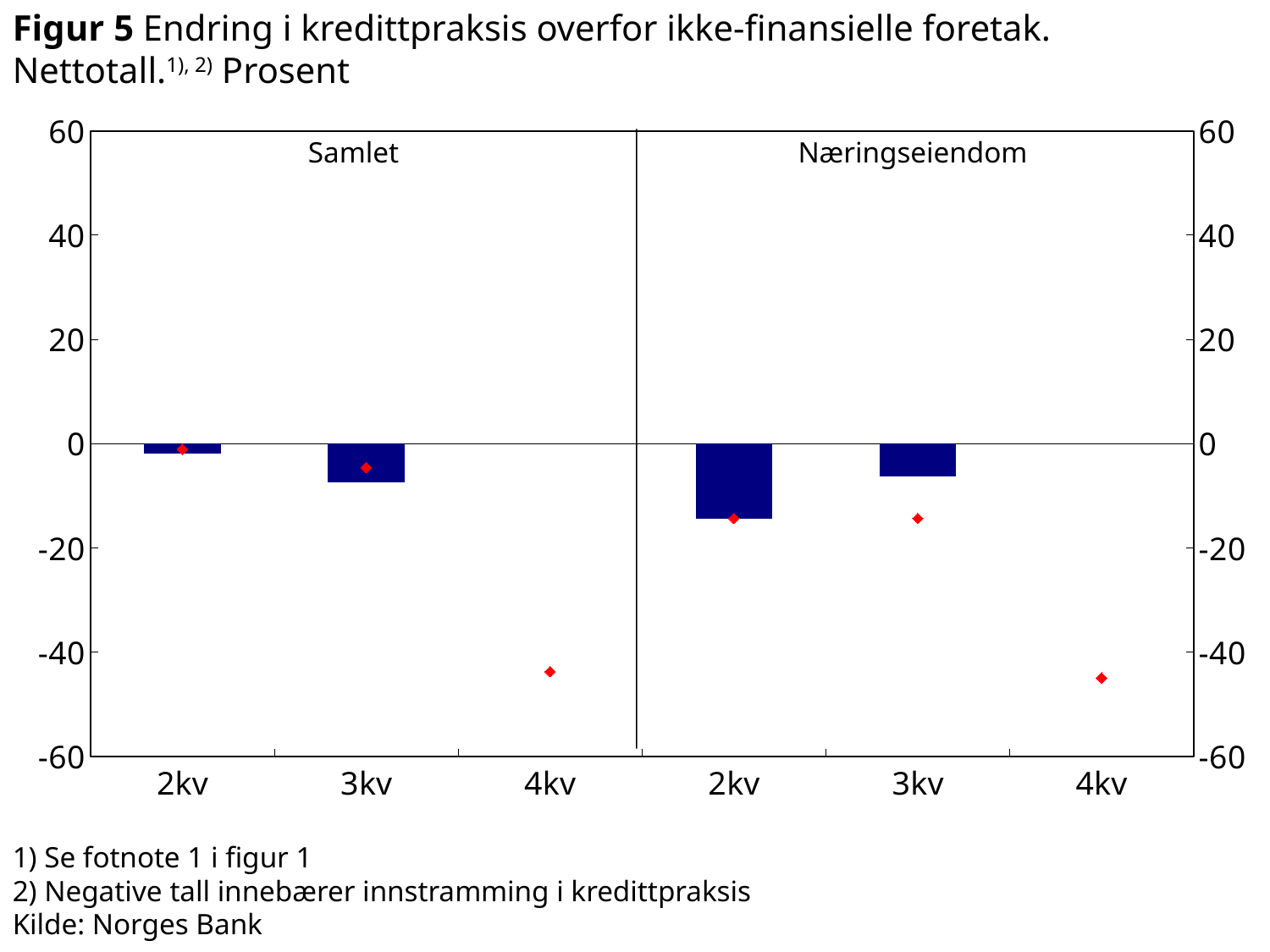
In the Samlet panel, is the bar for 3kv greater or less than -20? greater What kind of chart is shown on the slide? bar chart with red point markers (combination bar and line chart) In the Samlet panel, do the red markers rise or fall from 2kv to 4kv? fall In the Næringseiendom panel, is the red marker for 4kv greater or less than -40? less What is the source given for the chart? Norges Bank How many quarters are shown on the x axis of the Samlet panel? 3 In the Samlet panel, is the red marker for 4kv greater or less than -40? less Which panel has the lower (more negative) bar for 2kv, Samlet or Næringseiendom? Næringseiendom What are the names of the two panels in the chart? Samlet and Næringseiendom How many panels does the chart have? 2 In the Samlet panel, which quarter has the lowest red marker? 4kv